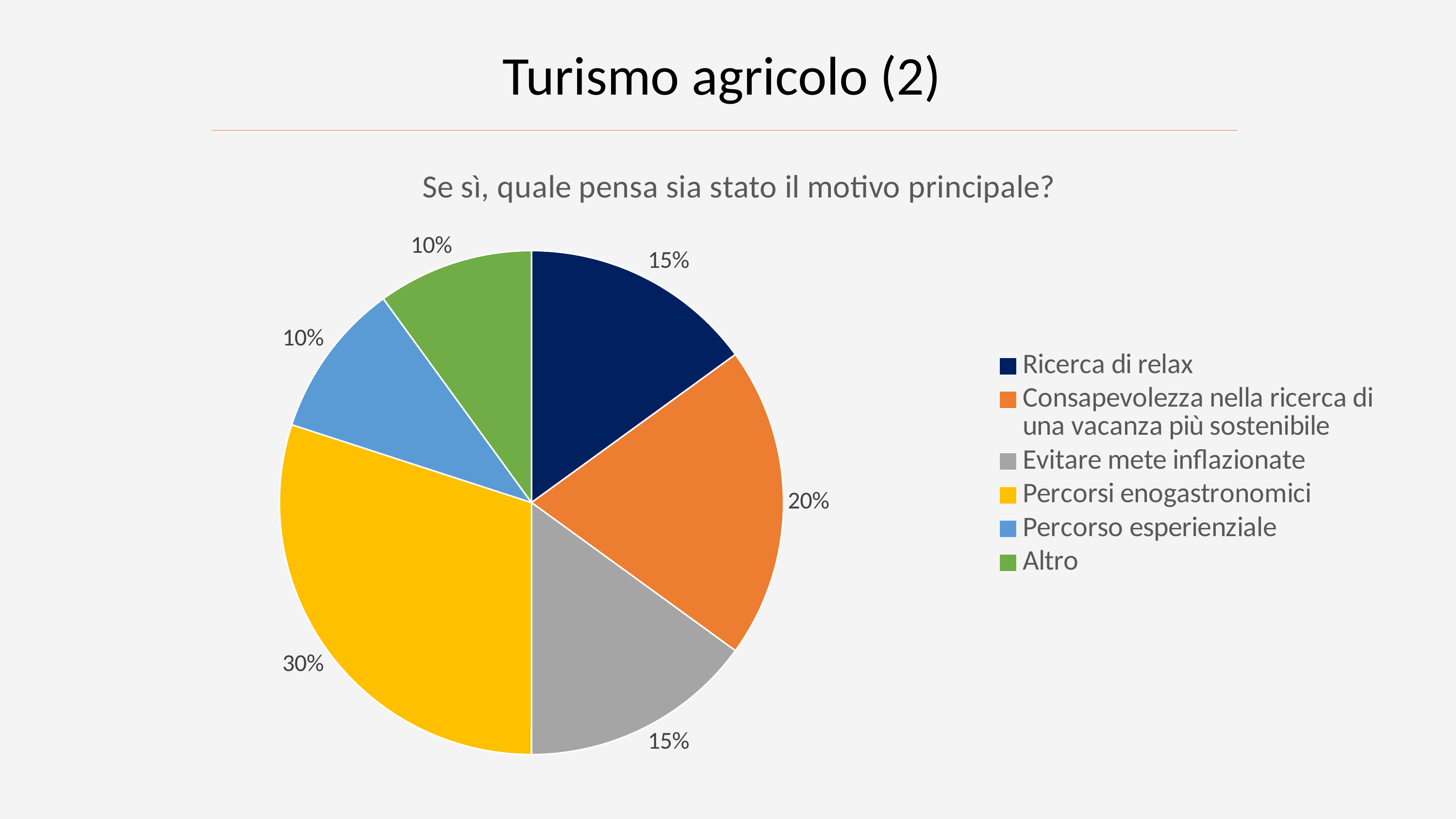
Which category has the largest slice of the pie? Percorsi enogastronomici How many slices does the pie chart have? 6 What share of the pie is 'Percorsi enogastronomici'? 30% What share of the pie is 'Consapevolezza nella ricerca di una vacanza più sostenibile'? 20% What is the chart's title? Se sì, quale pensa sia stato il motivo principale? What is the difference between the shares of 'Consapevolezza nella ricerca di una vacanza più sostenibile' and 'Ricerca di relax'? 5% What type of chart is shown on the slide? pie chart Which is larger: the share for 'Evitare mete inflazionate' or the share for 'Consapevolezza nella ricerca di una vacanza più sostenibile'? Consapevolezza nella ricerca di una vacanza più sostenibile What share of the pie is 'Ricerca di relax'? 15% What colour is the slice for 'Percorsi enogastronomici'? yellow What is the difference between the shares of 'Percorsi enogastronomici' and 'Percorso esperienziale'? 20%